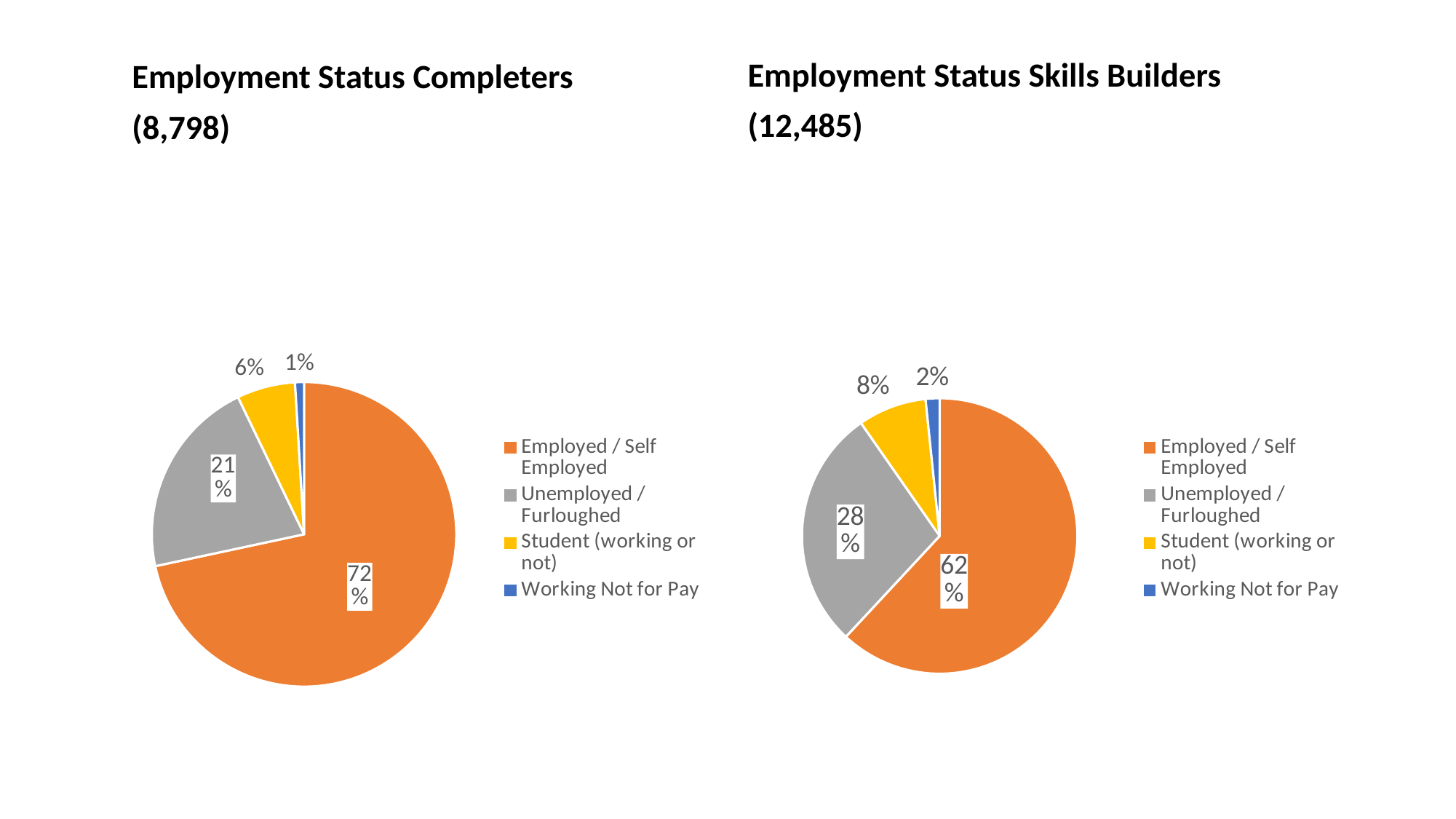
In the Employment Status Completers chart, what is the difference between the Employed / Self Employed and Unemployed / Furloughed shares? 51% How many categories does the Employment Status Completers chart show? 4 In the Employment Status Completers chart, what is the value for Student (working or not)? 6% In the Employment Status Skills Builders chart, what share of the pie is Unemployed / Furloughed? 28% What kind of chart is the Employment Status Skills Builders chart? Pie chart In the Employment Status Skills Builders chart, what is the difference between the Student (working or not) and Working Not for Pay shares? 6% What number is shown in parentheses under the title of the Employment Status Skills Builders chart? 12,485 In the Employment Status Completers chart, which category has the smallest slice? Working Not for Pay Which chart has the larger Unemployed / Furloughed share, Employment Status Completers or Employment Status Skills Builders? Employment Status Skills Builders In the Employment Status Skills Builders chart, which category has the largest slice? Employed / Self Employed In the Employment Status Completers chart, what share of the pie is Employed / Self Employed? 72% In the Employment Status Skills Builders chart, what is the value for Working Not for Pay? 2%